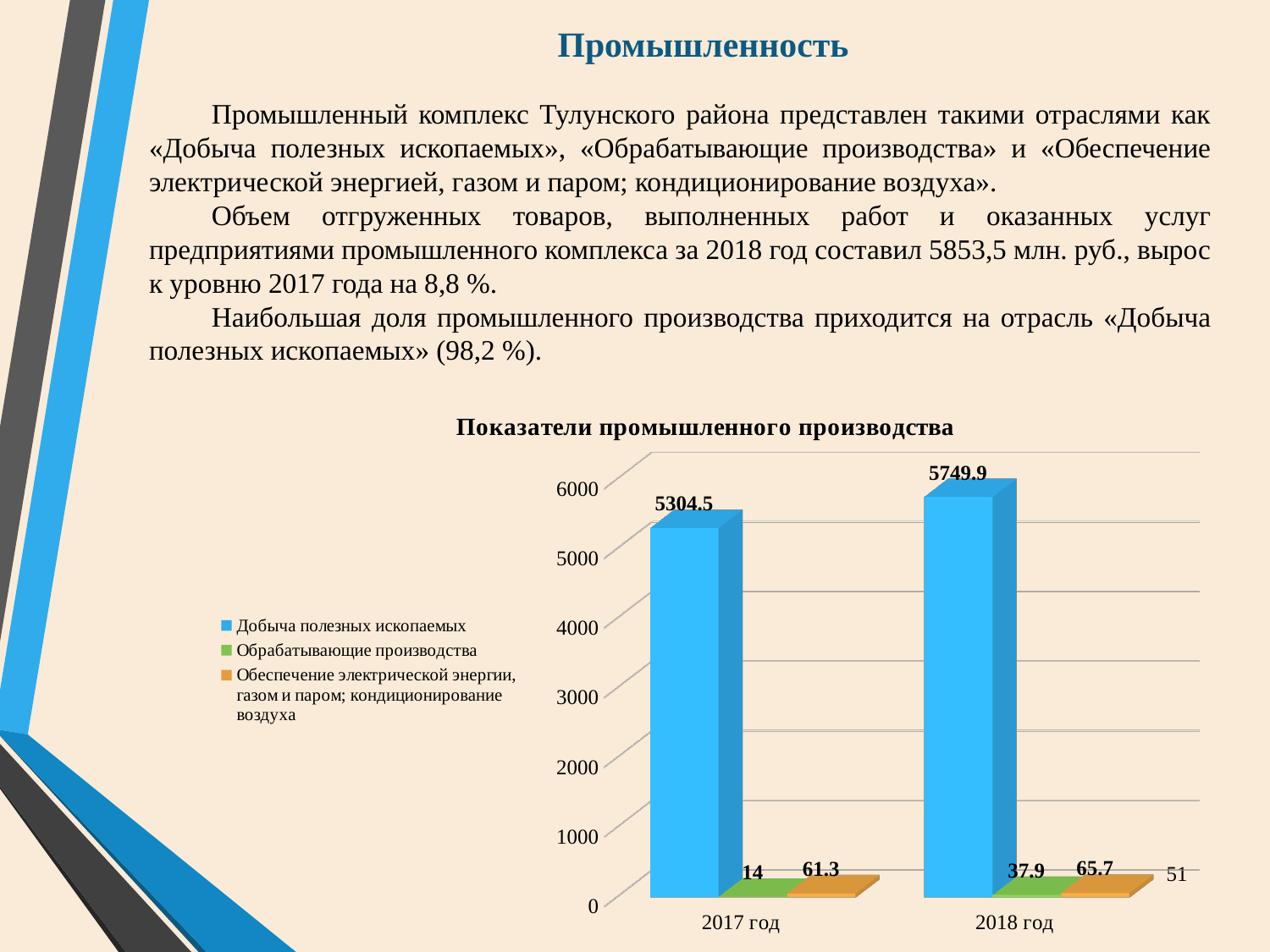
Which series has the lowest value in 2017 год? Обрабатывающие производства Which series has the highest value in 2018 год? Добыча полезных ископаемых What is the value for «Обрабатывающие производства» in 2017 год? 14 What is the title of the chart? Показатели промышленного производства Which is larger: «Обрабатывающие производства» in 2017 год or in 2018 год? 2018 год What is the value for «Обрабатывающие производства» in 2018 год? 37.9 What is the difference between the «Добыча полезных ископаемых» values for 2018 год and 2017 год? 445.4 What kind of chart is shown on the slide? Bar chart What is the value for «Обеспечение электрической энергии, газом и паром; кондиционирование воздуха» in 2018 год? 65.7 What is the value for «Добыча полезных ископаемых» in 2018 год? 5749.9 How many series does the legend list? 3 What is the value for «Добыча полезных ископаемых» in 2017 год? 5304.5